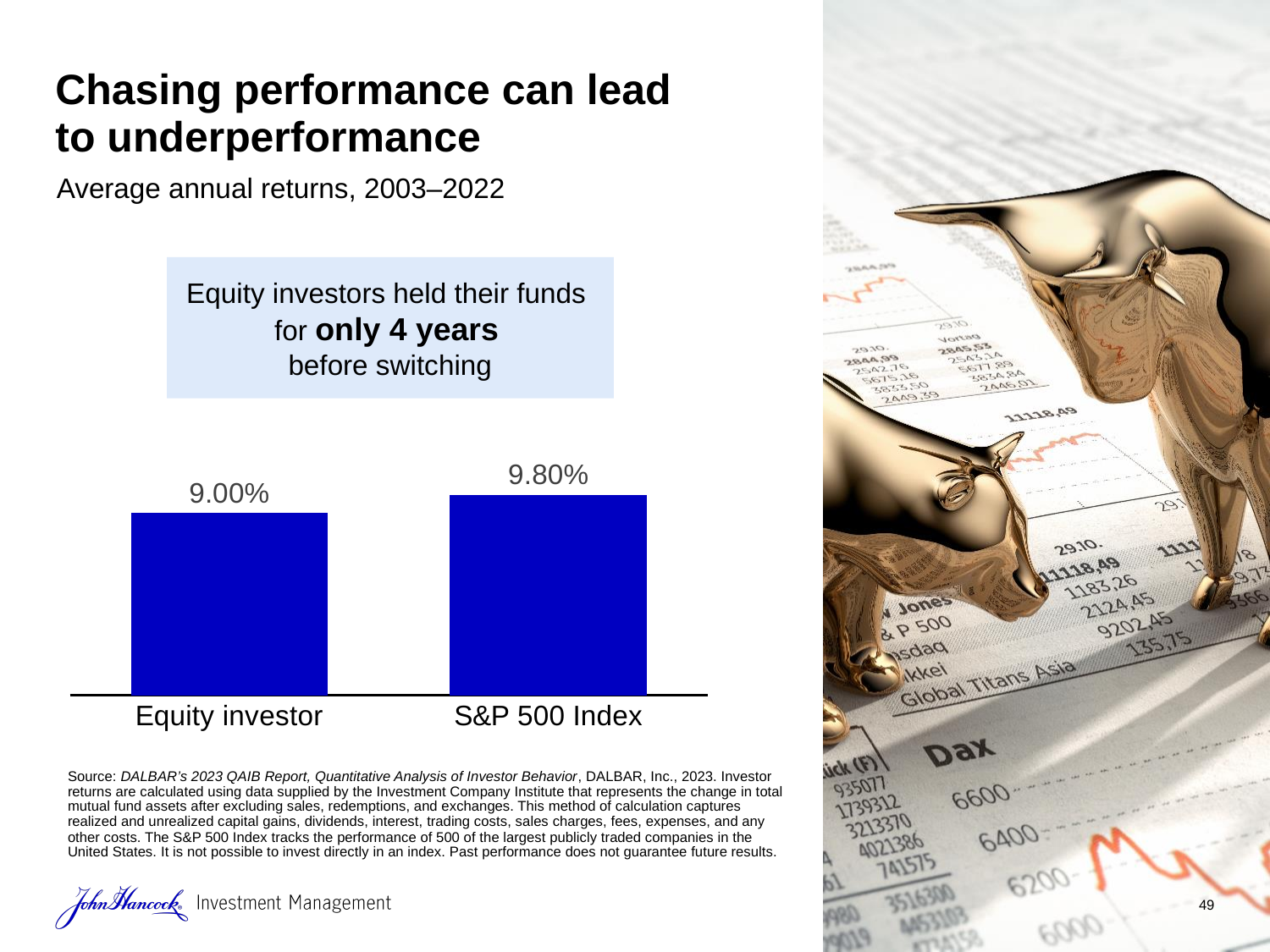
How many categories are plotted in the chart? 2 Which category has the higher average annual return? S&P 500 Index Is the return for the Equity investor larger or smaller than the return for the S&P 500 Index? smaller According to the callout box above the chart, how many years did equity investors hold their funds before switching? only 4 years What is the average annual return shown for the S&P 500 Index? 9.80% What time period do the average annual returns in the chart cover? 2003–2022 What is the average annual return shown for the Equity investor? 9.00% What is the difference between the S&P 500 Index return and the Equity investor return? 0.80% Which category has the lower average annual return? Equity investor What kind of chart is shown on the slide? bar chart